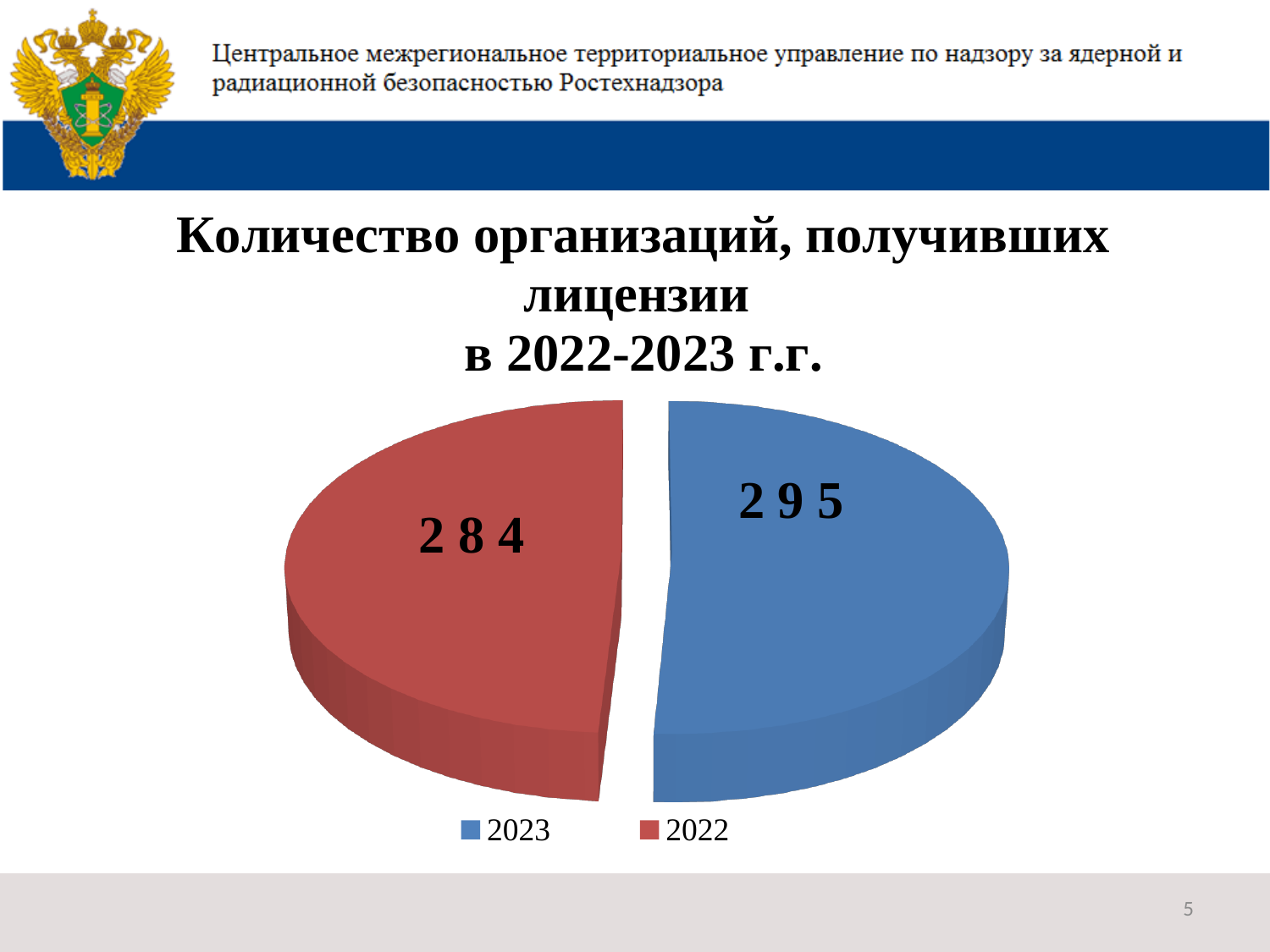
What is the total of the two values shown in the pie chart? 579 Is the value for 2022 larger or smaller than the value for 2023? smaller What is the title of the chart? Количество организаций, получивших лицензии в 2022-2023 г.г. How many slices does the pie chart have? 2 What is the value shown for 2022 on the pie chart? 284 Which year has the smaller slice in the pie chart? 2022 What colour is the slice for 2023? blue What kind of chart is shown on the slide? pie chart What is the difference between the values for 2023 and 2022? 11 Which year has the larger slice in the pie chart? 2023 What is the value shown for 2023 on the pie chart? 295 How many entries does the legend list? 2